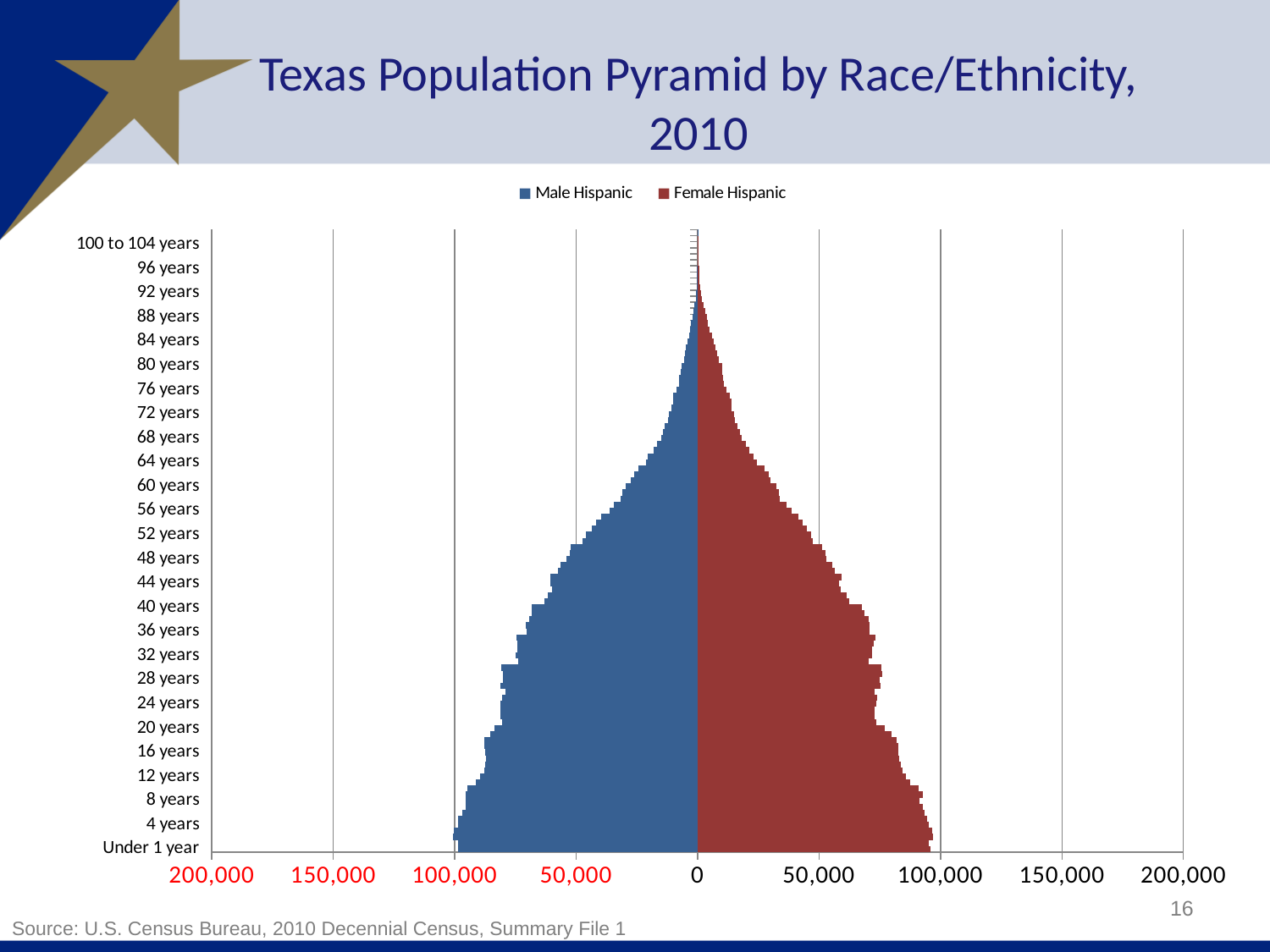
How many series does the legend list? 2 Is the value for Female Hispanic at 60 years greater or less than 50,000? less Do the Male Hispanic values generally rise or fall as age increases from Under 1 year to 100 to 104 years? Fall Which colour represents the Female Hispanic series? Red Is the value for Female Hispanic at 20 years greater or less than 50,000? greater What are the two series named in the legend? Male Hispanic and Female Hispanic What kind of chart is shown on the slide? Bar chart Is the value for Male Hispanic at 40 years greater or less than 50,000? greater Which is larger for Female Hispanic: the value at 4 years or the value at 76 years? 4 years